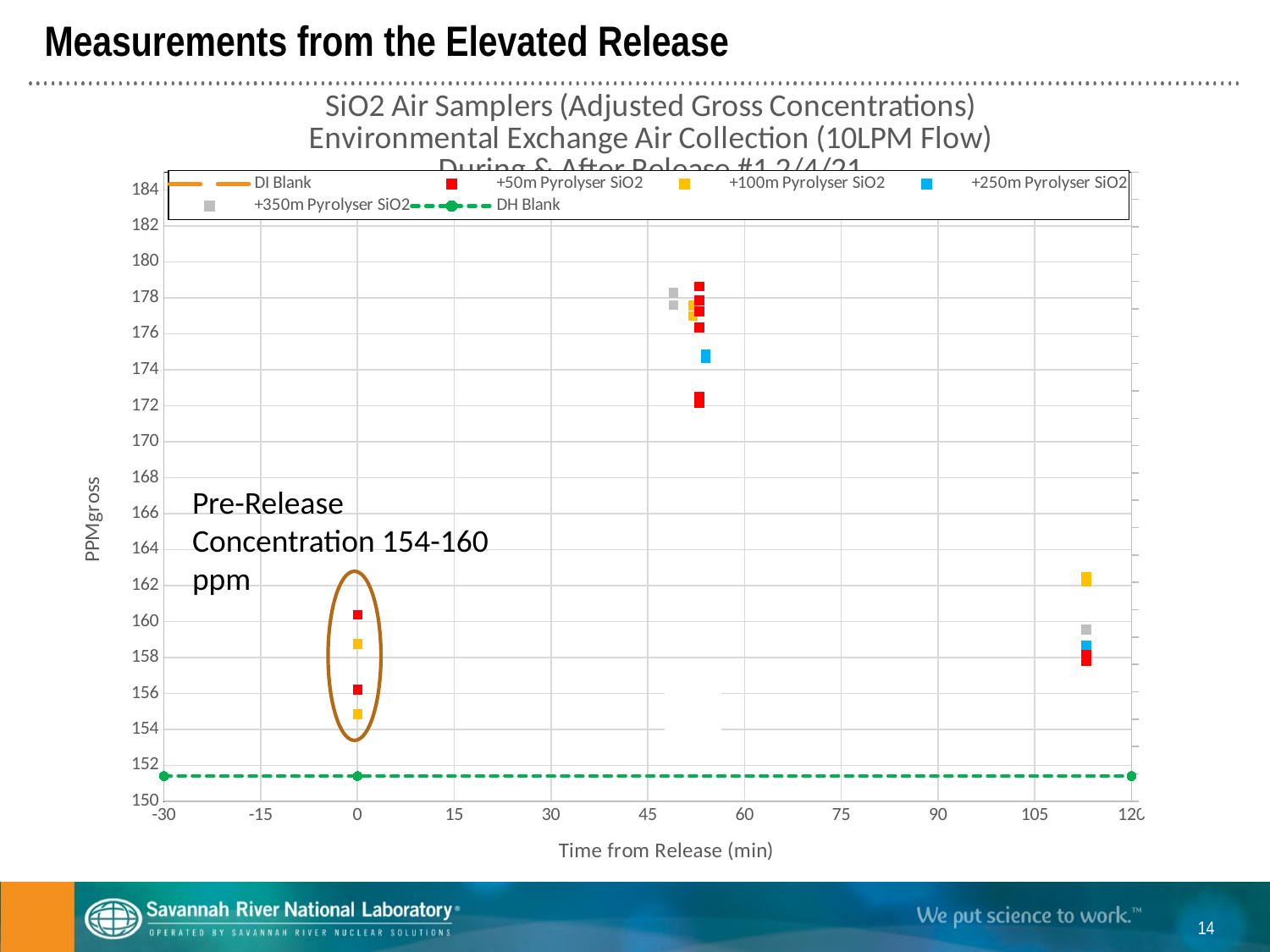
Is the +250m Pyrolyser SiO2 value plotted around 54 minutes greater or less than 176? less How many series does the legend list? 6 At 0 minutes, which is larger: the highest +50m Pyrolyser SiO2 value or the highest +100m Pyrolyser SiO2 value? +50m Pyrolyser SiO2 What kind of chart is shown on the slide? scatter chart Is the +350m Pyrolyser SiO2 value plotted around 113 minutes greater or less than 162? less What is the title of the x axis? Time from Release (min) Is the highest +50m Pyrolyser SiO2 value plotted around 53 minutes greater or less than 176? greater Around 113 minutes, which is larger: the +100m Pyrolyser SiO2 value or the +50m Pyrolyser SiO2 value? +100m Pyrolyser SiO2 What does the annotation inside the chart say about the pre-release concentration? Pre-Release Concentration 154-160 ppm